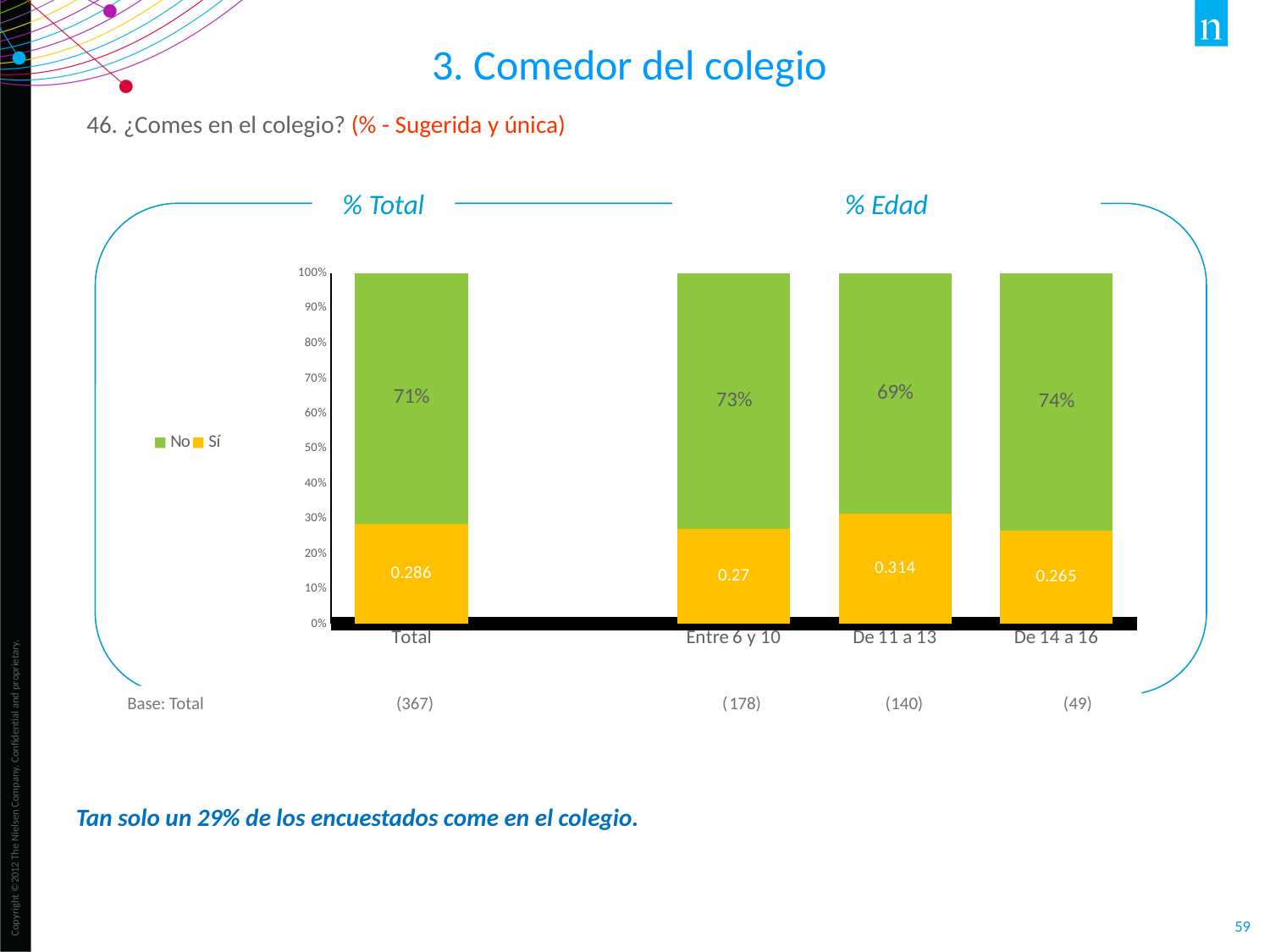
What is the value of the "No" series for the "Total" category? 71% Which has a larger "Sí" value: "Entre 6 y 10" or "De 11 a 13"? De 11 a 13 Which category has the lowest value for the "Sí" series? De 14 a 16 How many categories are shown on the x axis of the chart? 4 What is the value of the "No" series for the "De 14 a 16" category? 74% What is the value of the "Sí" series for the "Entre 6 y 10" category? 0.27 Which category has the highest value for the "No" series? De 14 a 16 How many series does the chart legend list? 2 What is the value of the "Sí" series for the "De 11 a 13" category? 0.314 What kind of chart is shown on the slide? Stacked bar chart Is the "No" value for "Total" greater or less than 50%? greater What is the difference between the "No" values for "De 14 a 16" and "De 11 a 13"? 5%